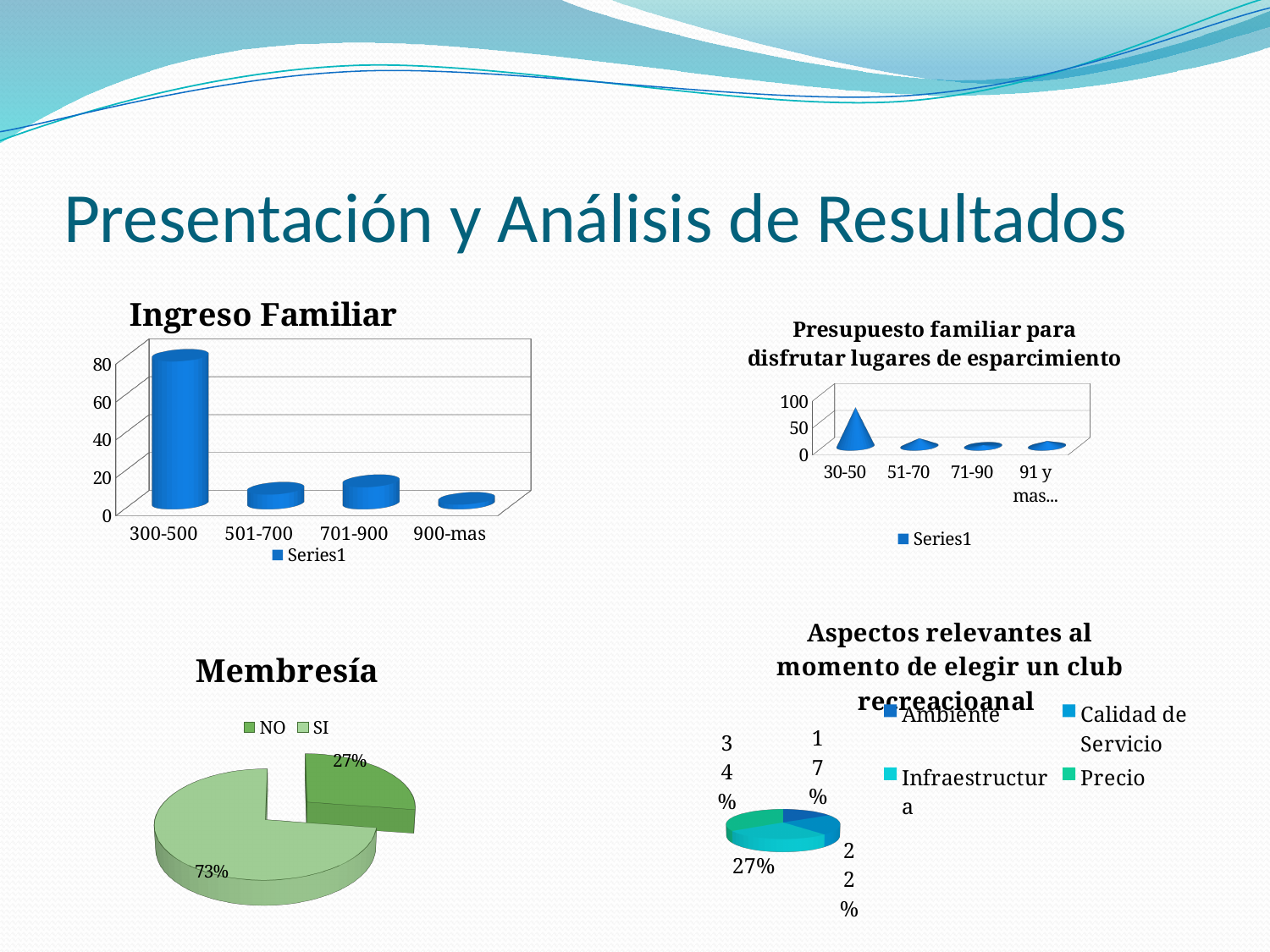
In the Presupuesto familiar para disfrutar lugares de esparcimiento chart, which category has the highest value? 30-50 In the Ingreso Familiar chart, which category has the highest value? 300-500 How many categories are shown on the x axis of the Ingreso Familiar chart? 4 In the Membresía pie chart, what is the difference between the SI and NO shares? 46% In the Presupuesto familiar para disfrutar lugares de esparcimiento chart, is the value for 71-90 greater or less than 50? less What kind of chart is the Ingreso Familiar chart? bar chart In the Ingreso Familiar chart, is the value for 501-700 greater or less than 20? less In the Ingreso Familiar chart, is the value for 300-500 greater or less than 60? greater In the Ingreso Familiar chart, which category has the lowest value? 900-mas In the Membresía pie chart, what percentage is shown for NO? 27% In the Membresía pie chart, what percentage is shown for SI? 73% How many entries does the legend of the Aspectos relevantes al momento de elegir un club recreacioanal chart list? 4